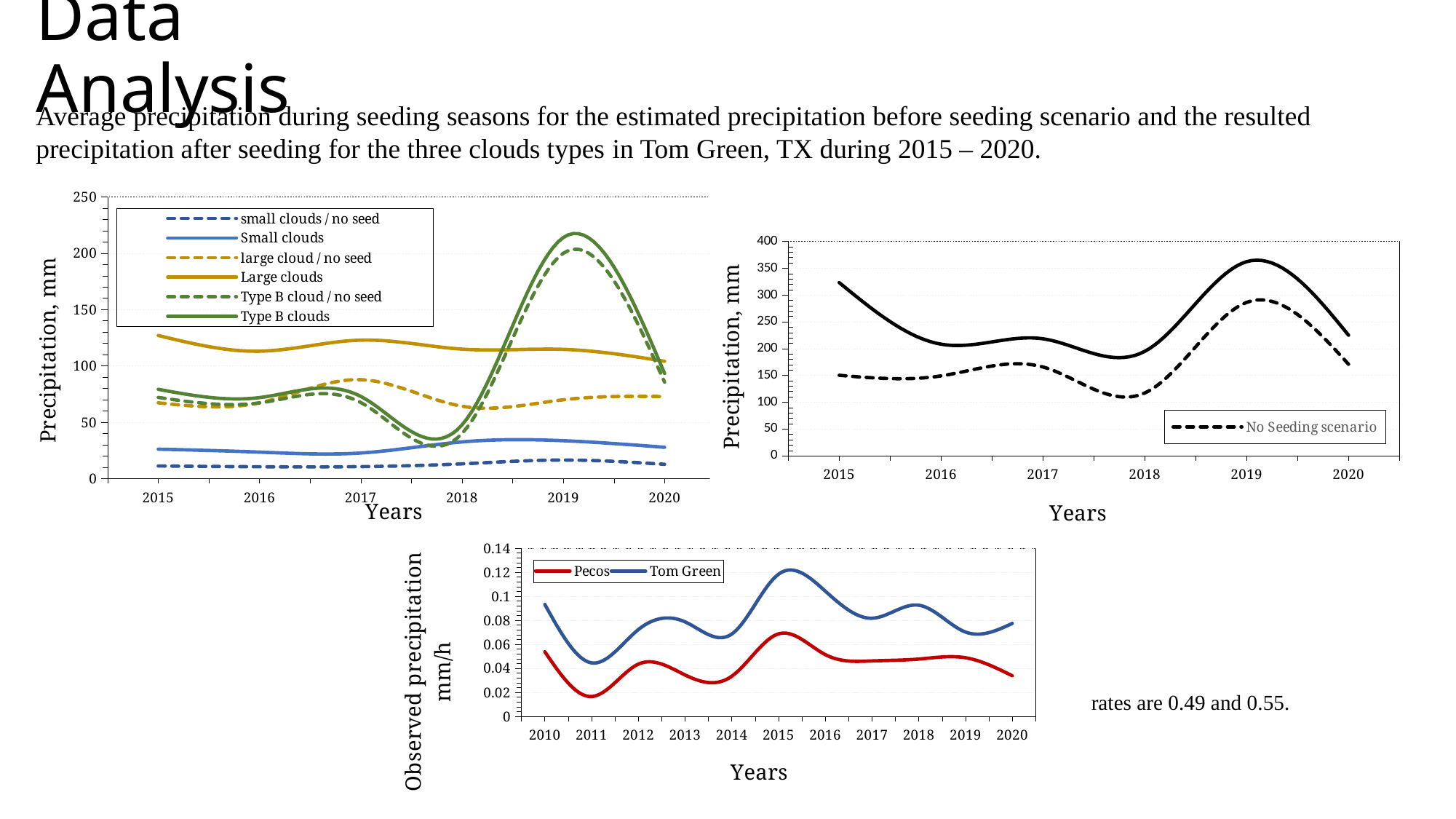
On the top-left chart, is the value for Type B clouds in 2019 greater or less than 200? greater On the bottom chart, is the value for Tom Green in 2015 greater or less than 0.1? greater On the top-left chart, which series has the lowest value in 2015? small clouds / no seed On the bottom chart, how many series does the legend list? 2 On the top-right chart, does the No Seeding scenario rise or fall from 2019 to 2020? fall On the top-left chart, how many series does the legend list? 6 On the top-left chart, is the value for Large clouds in 2015 greater or less than 100? greater On the bottom chart, which series is higher in 2015, Pecos or Tom Green? Tom Green What kind of chart is the top-right chart? line chart On the top-left chart, which series has the highest value in 2019? Type B clouds On the top-right chart, in which year does the No Seeding scenario reach its highest value? 2019